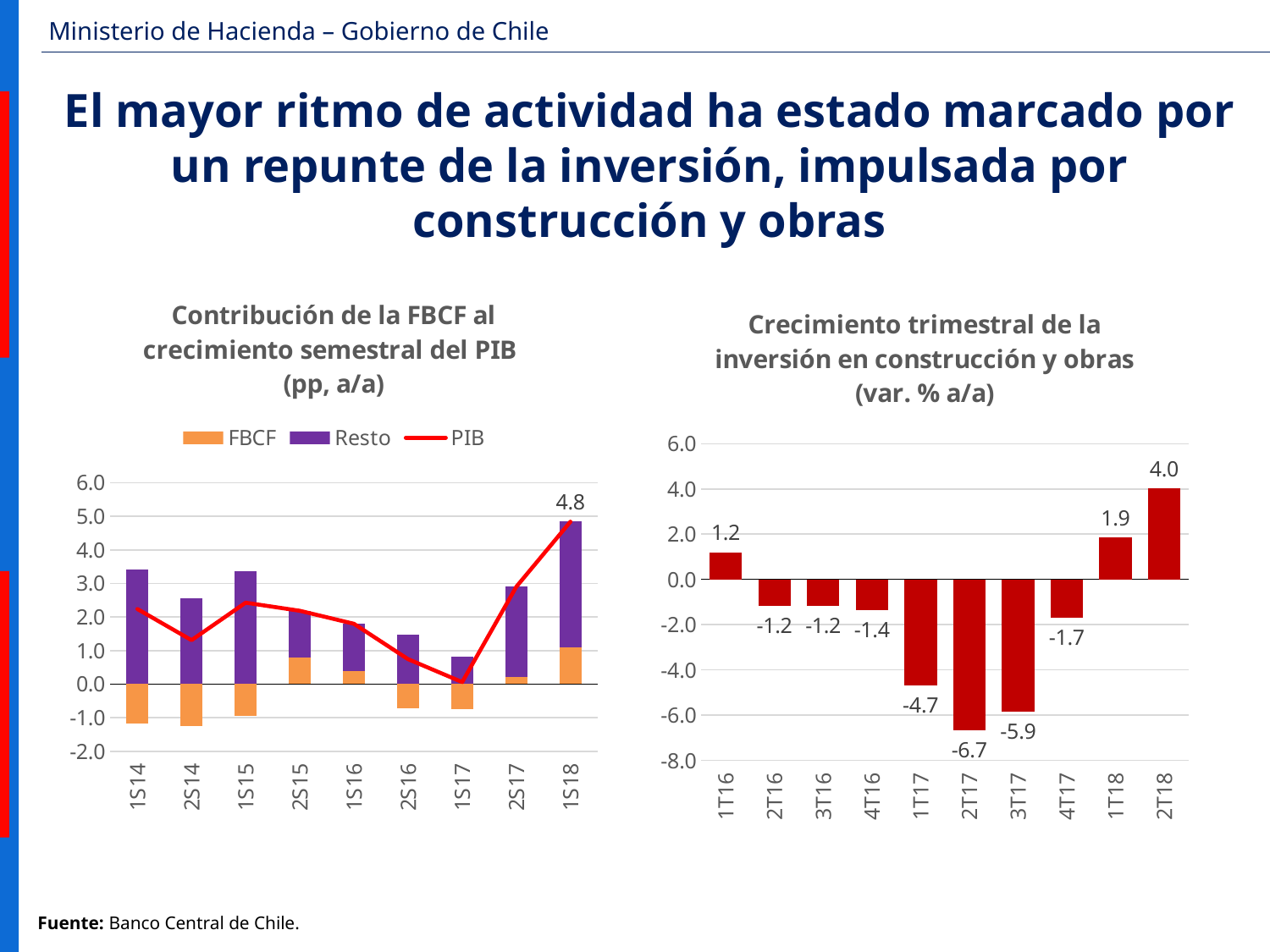
In the chart 'Crecimiento trimestral de la inversión en construcción y obras', which quarter has the lowest value? 2T17 In the chart 'Crecimiento trimestral de la inversión en construcción y obras', do the values rise or fall from 2T17 to 2T18? rise How many semesters are shown on the x axis of the chart 'Contribución de la FBCF al crecimiento semestral del PIB'? 9 In the chart 'Crecimiento trimestral de la inversión en construcción y obras', which quarter has the highest value? 2T18 How many series does the legend list in the chart 'Contribución de la FBCF al crecimiento semestral del PIB'? 3 In the chart 'Crecimiento trimestral de la inversión en construcción y obras', what is the difference between the values for 2T18 and 1T18? 2.1 In the chart 'Crecimiento trimestral de la inversión en construcción y obras', which is larger, the value for 3T17 or the value for 2T17? 3T17 In the chart 'Contribución de la FBCF al crecimiento semestral del PIB', what is the PIB value for 1S18? 4.8 In the chart 'Crecimiento trimestral de la inversión en construcción y obras', what is the value for 1T17? -4.7 In the chart 'Contribución de la FBCF al crecimiento semestral del PIB', is the PIB value for 1S17 greater or less than 1.0? less In the chart 'Crecimiento trimestral de la inversión en construcción y obras', what is the value for 2T18? 4.0 How many quarters are shown in the chart 'Crecimiento trimestral de la inversión en construcción y obras'? 10